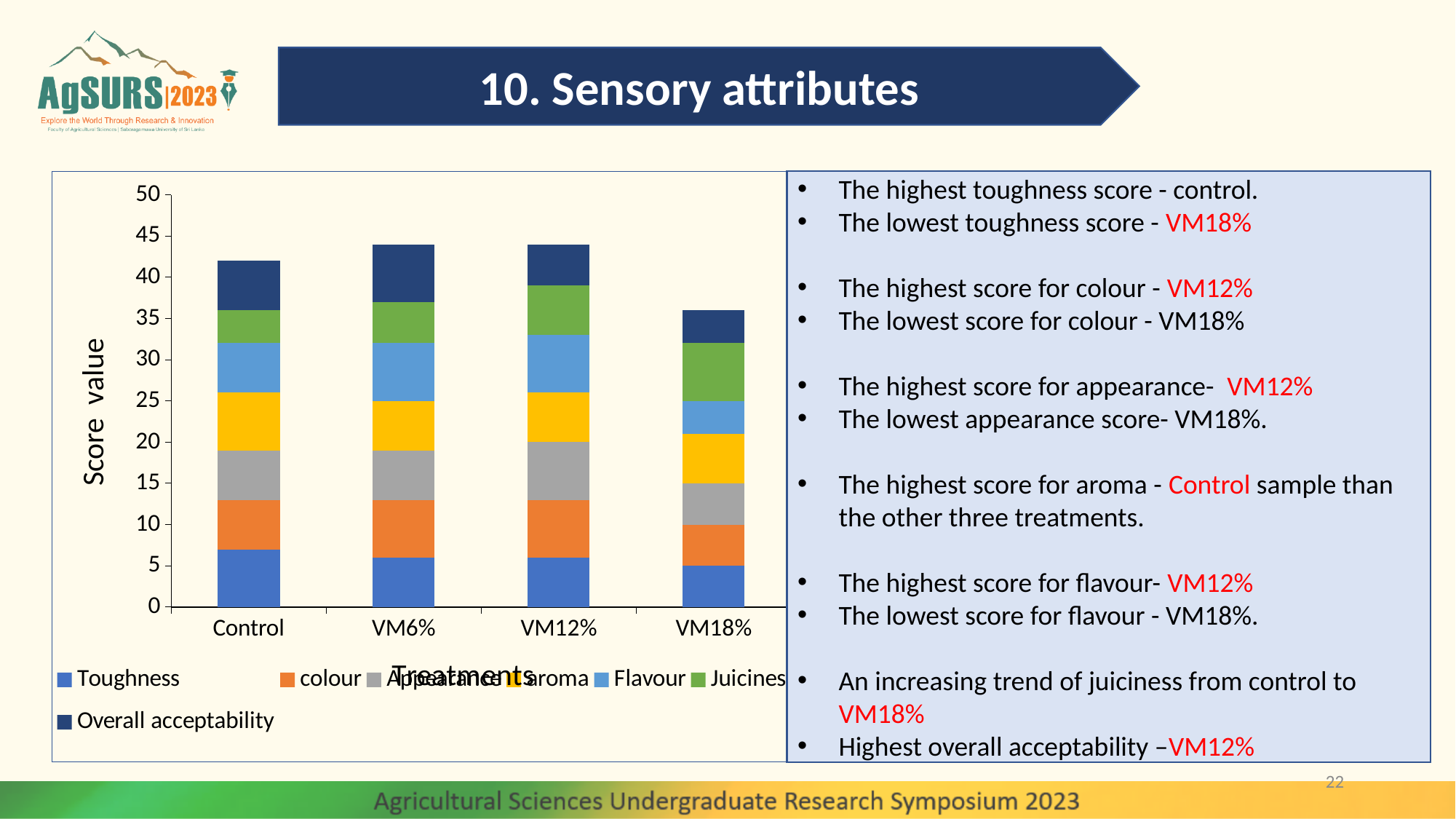
Is the total stacked score for Control greater or less than 40? greater Is the total stacked score for VM6% greater or less than 40? greater What kind of chart is shown on the slide? Stacked bar chart Which has the larger total stacked score, VM12% or VM18%? VM12% Which treatment has the lowest total stacked score in the chart? VM18% Which has the larger total stacked score, Control or VM18%? Control What is the title of the y axis of the chart? Score value Is the Toughness score for Control greater or less than 10? less How many series does the chart legend list? 7 How many treatments (categories) are shown on the x axis of the chart? 4 What is the title of the x axis of the chart? Treatments